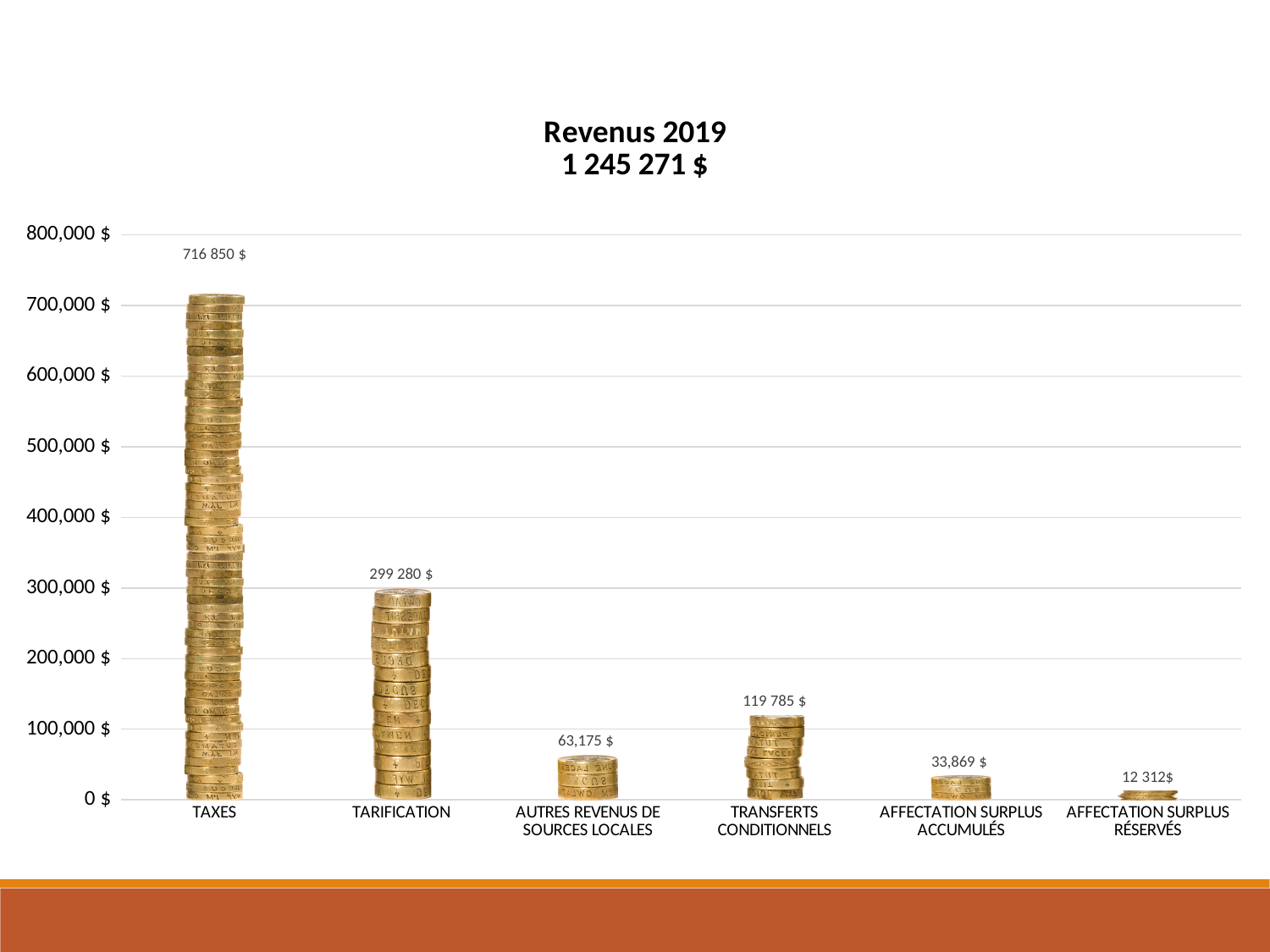
How many categories are shown on the x axis? 6 What is the value for TARIFICATION? 299 280 $ What is the value for TAXES? 716 850 $ What is the difference between the values for TAXES and TARIFICATION? 417 570 $ What is the value for AFFECTATION SURPLUS ACCUMULÉS? 33,869 $ What is the value for AFFECTATION SURPLUS RÉSERVÉS? 12 312$ Which category has the highest value? TAXES What is the value for TRANSFERTS CONDITIONNELS? 119 785 $ What total amount is shown in the chart title? 1 245 271 $ Which is larger, the value for TRANSFERTS CONDITIONNELS or AUTRES REVENUS DE SOURCES LOCALES? TRANSFERTS CONDITIONNELS Which category has the lowest value? AFFECTATION SURPLUS RÉSERVÉS What kind of chart is shown on the slide? bar chart